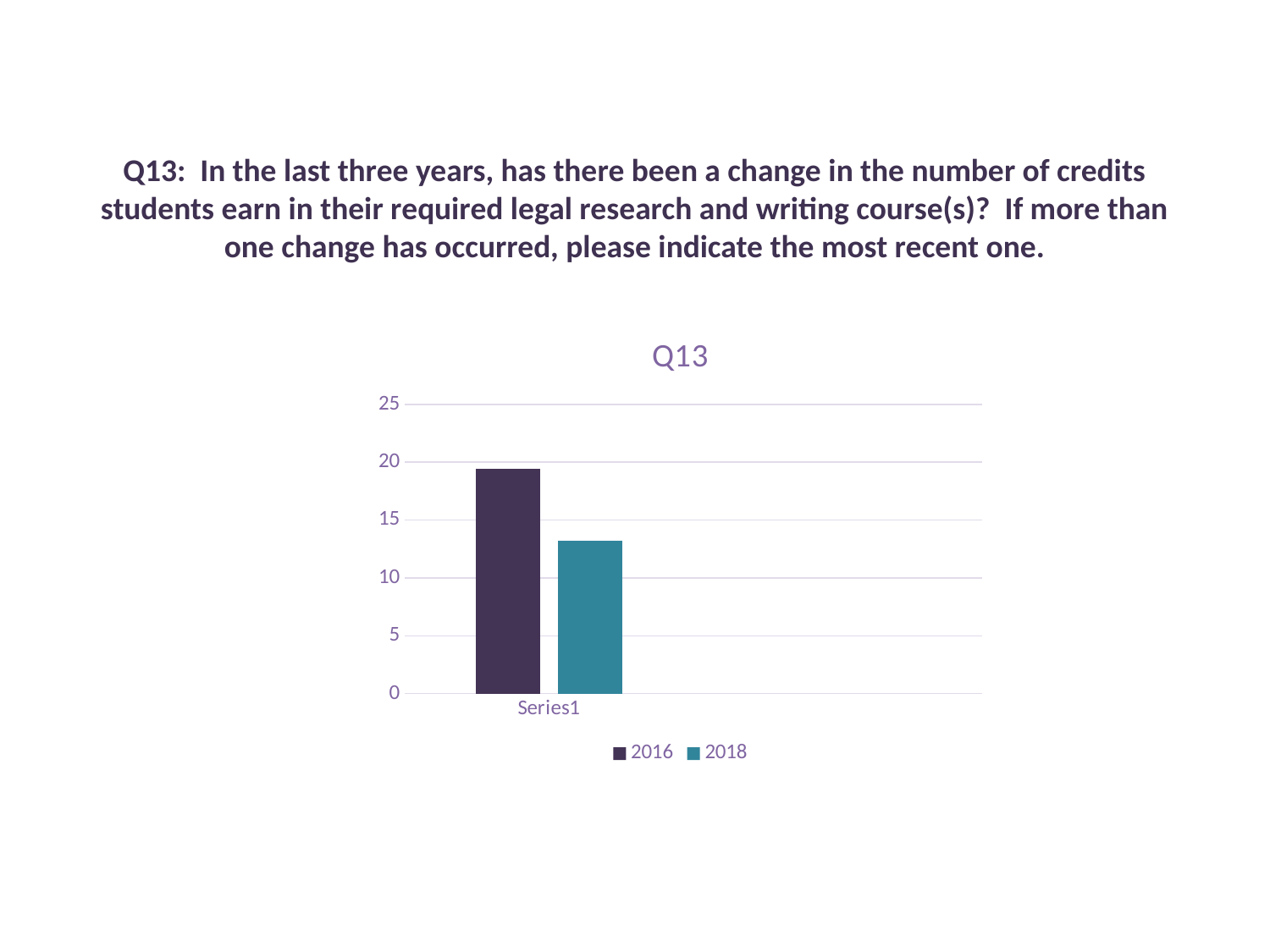
Which series has the lowest value? 2018 Which series has the highest value? 2016 How many series does the legend list? 2 Is the value for 2018 greater or less than 10? greater Is the value for 2016 greater or less than 15? greater Is the value for 2018 greater or less than 15? less What kind of chart is shown on the slide? bar chart How many categories are shown on the x axis? 1 Which series has the taller bar, 2016 or 2018? 2016 What is the title of the chart? Q13 Which series are listed in the legend? 2016 and 2018